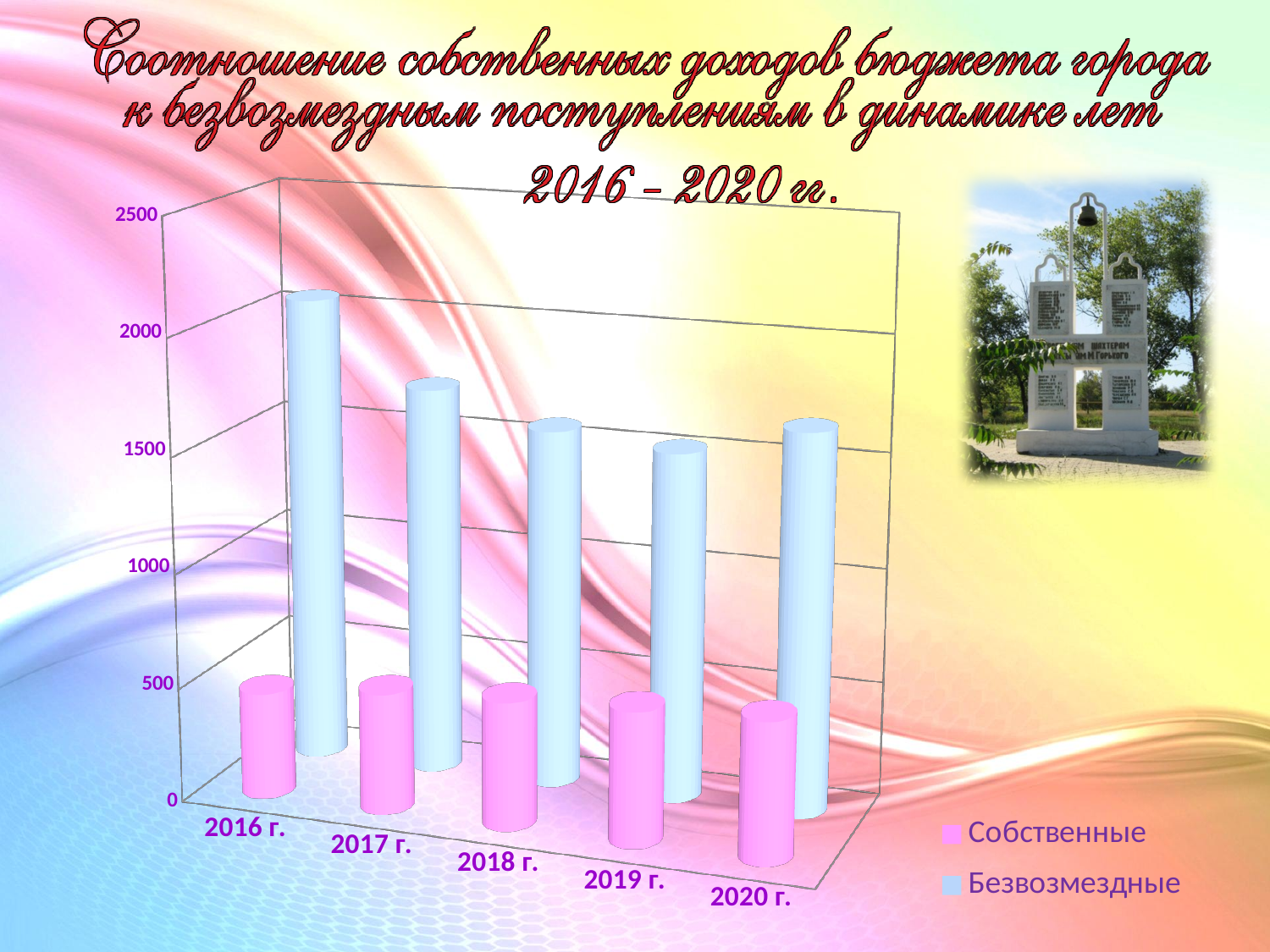
Is the value for Безвозмездные in 2017 г. greater or less than 2000? less How many series does the chart legend list? 2 Which series is shown in light blue in the chart? Безвозмездные What kind of chart is shown on the slide? bar chart Which is larger in 2020 г.: Собственные or Безвозмездные? Безвозмездные How many years (categories) are shown on the x axis of the chart? 5 Is the value for Собственные in 2018 г. greater or less than 1000? less Which is larger in 2016 г.: Собственные or Безвозмездные? Безвозмездные Do the values for Безвозмездные rise or fall from 2016 г. to 2019 г.? fall Which series is shown in pink in the chart? Собственные In which year is the value for Безвозмездные the highest? 2016 г.